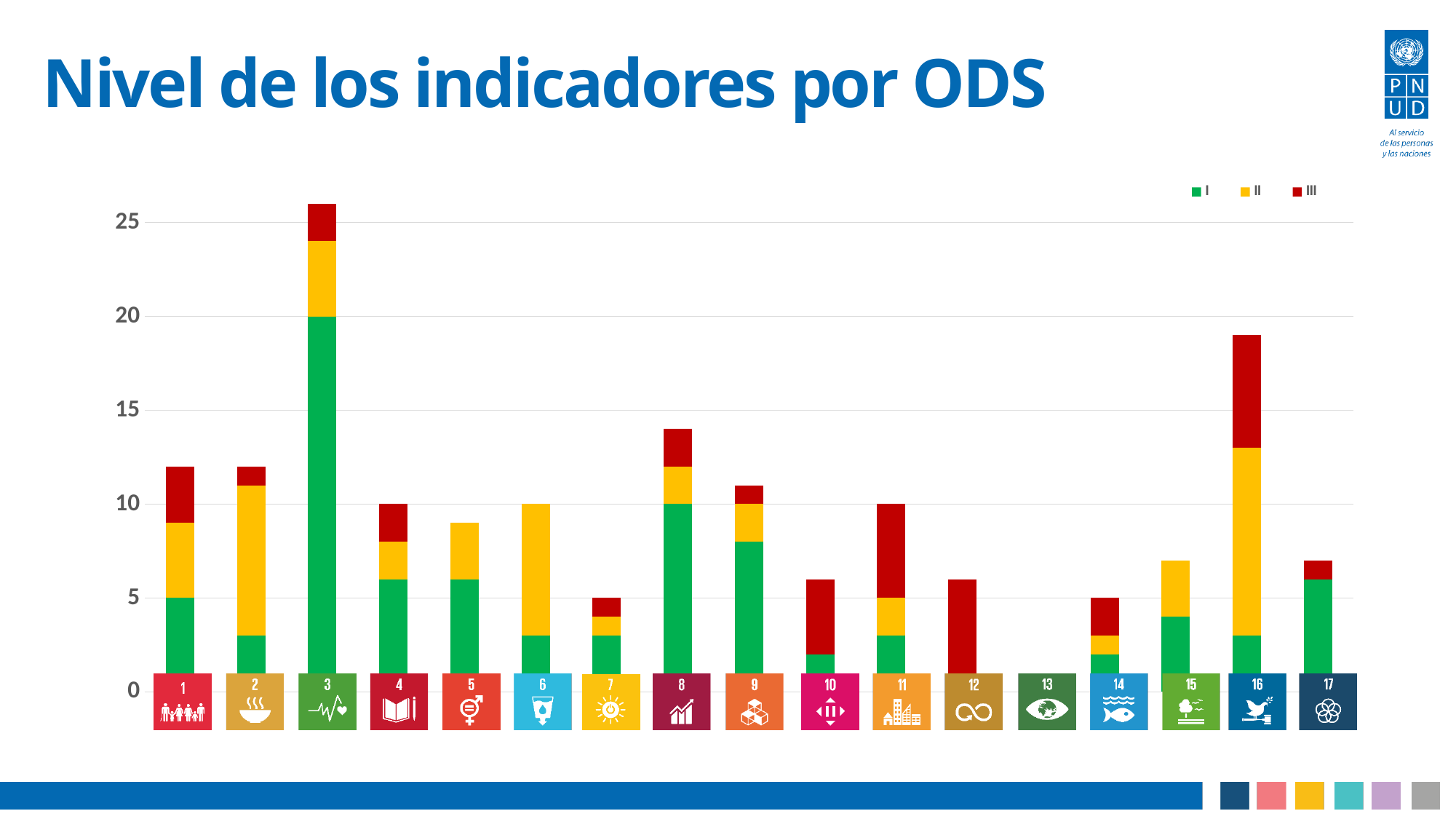
How many series does the legend list? 3 What is the total height of the stacked bar for ODS 7? 5 Which ODS has the tallest stacked bar? ODS 3 What is the value of series I (green) for ODS 3? 20 Is the total for ODS 4 greater or less than 15? less Is the total for ODS 16 greater or less than 15? greater What are the legend entries of the chart? I, II, III Which ODS has no bar at all (the lowest total)? ODS 13 What is the total height of the stacked bar for ODS 6? 10 Which has the taller stacked bar, ODS 8 or ODS 9? ODS 8 What kind of chart is shown on the slide? Stacked bar chart How many ODS categories are shown along the x axis? 17